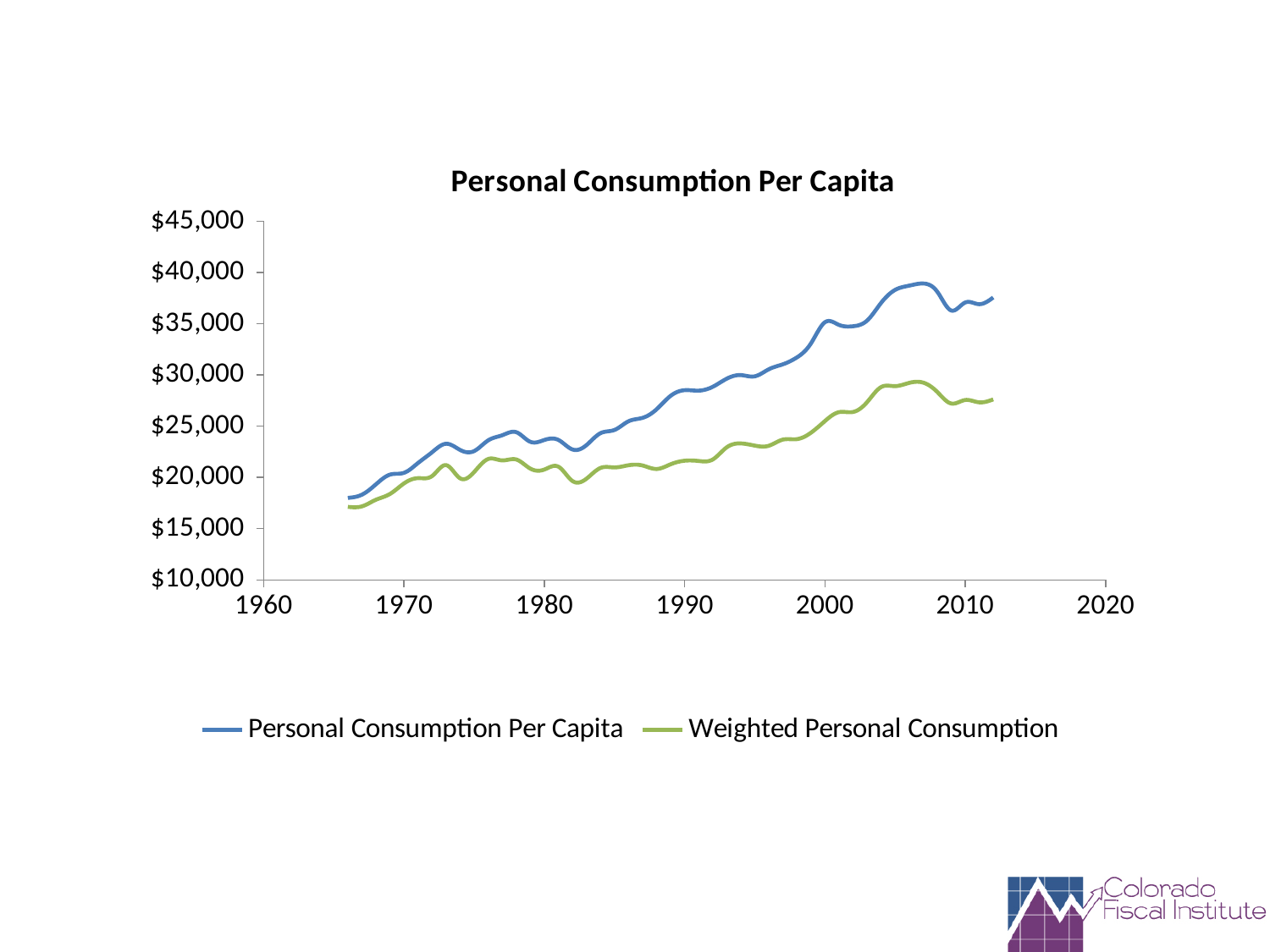
How many series does the legend list? 2 What kind of chart is shown on the slide? line chart Which series is higher in 2000, Personal Consumption Per Capita or Weighted Personal Consumption? Personal Consumption Per Capita What colour is the Weighted Personal Consumption line? green Which series reaches the higher peak value over the period shown? Personal Consumption Per Capita Does the Personal Consumption Per Capita line generally rise or fall from the 1960s to 2012? rise Is the value for Personal Consumption Per Capita in 2010 greater or less than $35,000? greater What is the title of the chart? Personal Consumption Per Capita Is the value for Personal Consumption Per Capita in 1970 greater or less than $25,000? less Is the value for Weighted Personal Consumption in 1980 greater or less than $25,000? less